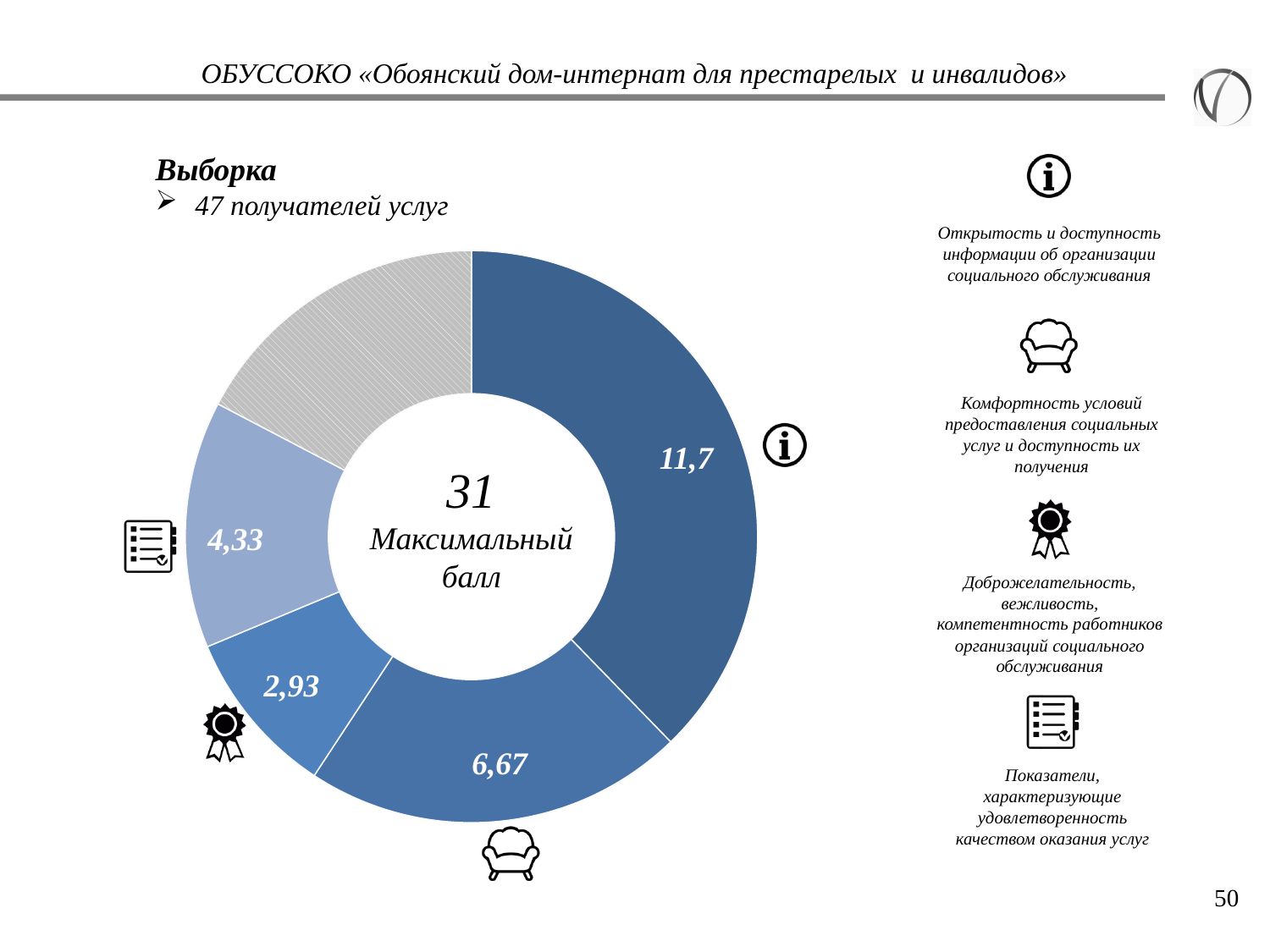
What value is shown for the slice marked with the medal icon (Доброжелательность, вежливость, компетентность работников)? 2,93 What is the difference between the checklist icon slice (4,33) and the medal icon slice (2,93)? 1,4 What kind of chart is shown on the slide? Doughnut (pie) chart How many slices of the chart have a printed data label? 4 Which is larger: the value for the checklist icon slice or the medal icon slice? The checklist icon slice (4,33) Which labelled slice of the chart has the lowest value? 2,93 (Доброжелательность, вежливость, компетентность работников) What value is shown for the slice marked with the checklist icon (Показатели, характеризующие удовлетворенность качеством оказания услуг)? 4,33 What is the difference between the value for the information icon slice (11,7) and the armchair icon slice (6,67)? 5,03 What value is shown for the slice marked with the armchair icon (Комфортность условий предоставления социальных услуг и доступность их получения)? 6,67 What value is shown for the slice marked with the information icon (Открытость и доступность информации об организации социального обслуживания)? 11,7 What maximum score is written in the centre of the chart? 31 Which labelled slice of the chart has the highest value? 11,7 (Открытость и доступность информации)